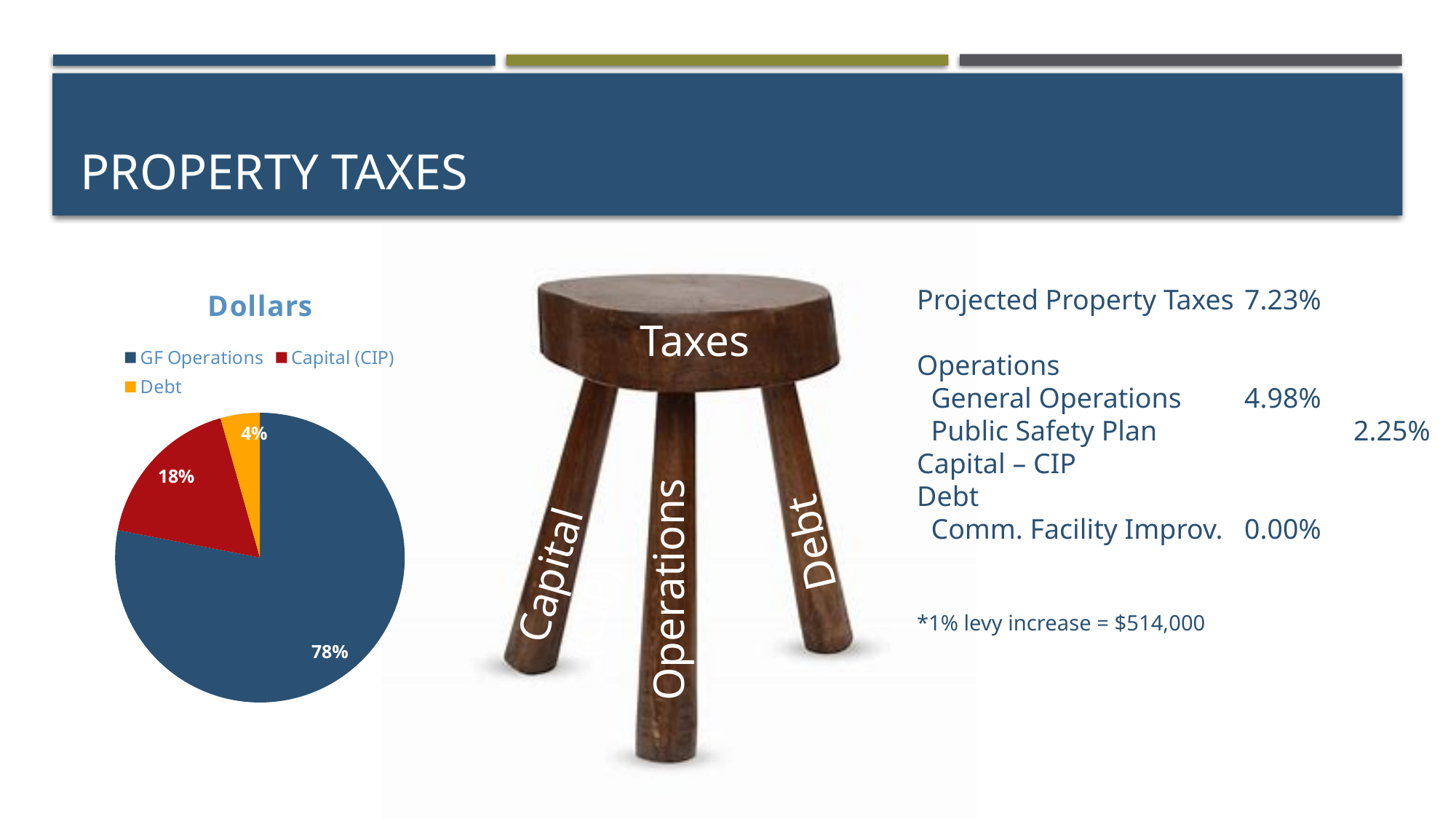
How many categories does the pie chart show? 3 What share of the pie does Capital (CIP) represent? 18% Which category has the largest slice of the pie chart? GF Operations How many entries does the pie chart's legend list? 3 What share of the pie does GF Operations represent? 78% What type of chart is shown under the title "Dollars"? pie chart What share of the pie does Debt represent? 4% Which slice is larger, Capital (CIP) or Debt? Capital (CIP) What is the difference in percentage points between the GF Operations slice and the Capital (CIP) slice? 60 What is the title of the pie chart? Dollars What colour is the Debt slice in the pie chart? orange Which category has the smallest slice of the pie chart? Debt